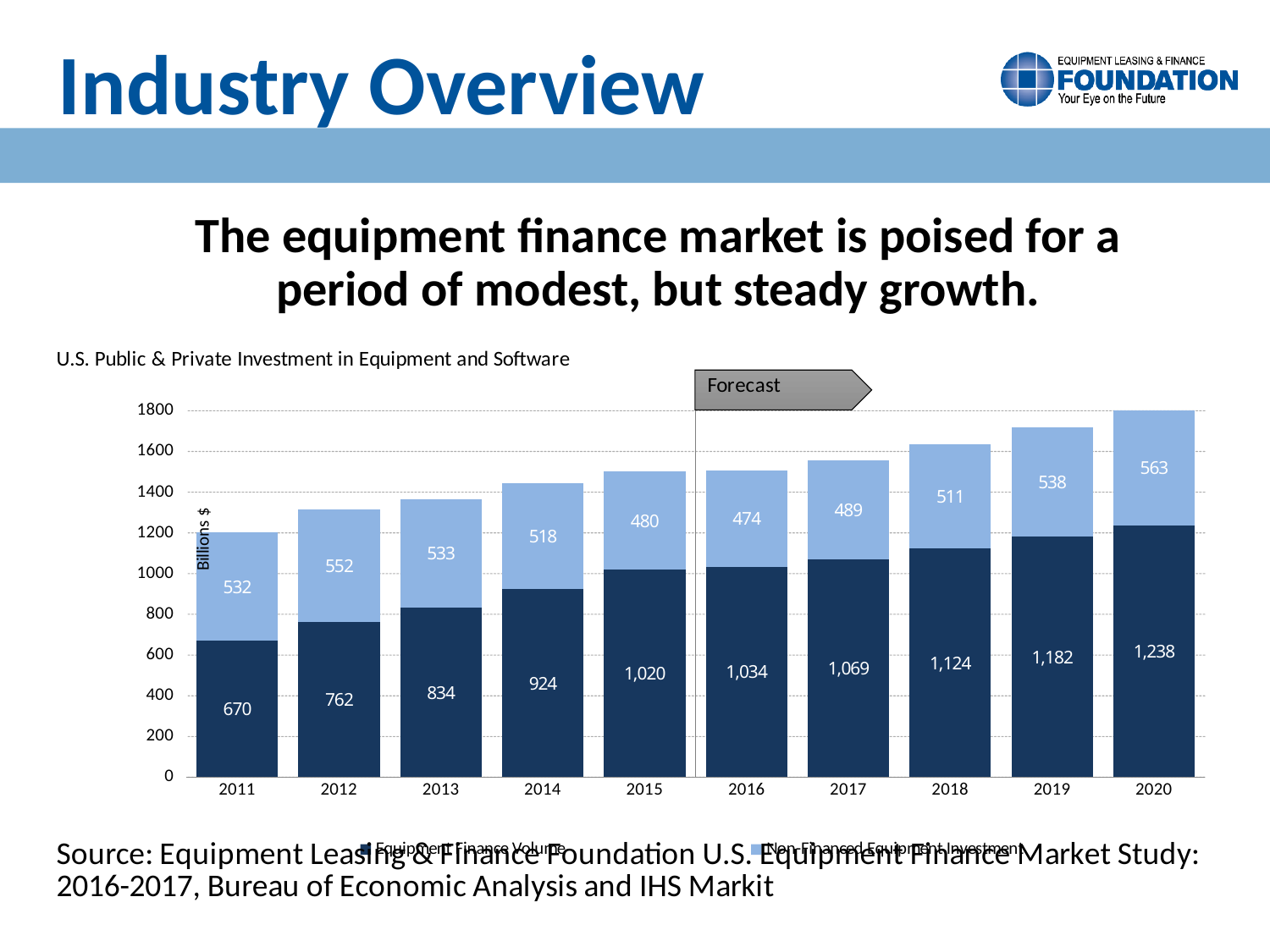
Is the total height of the 2020 stacked bar greater or less than 1600? greater What is the difference between the dark blue (bottom) segment values for 2020 and 2011? 568 Which year has the larger light blue (top) segment, 2012 or 2013? 2012 What is the value of the dark blue (bottom) segment for 2011? 670 How many years are shown on the x axis? 10 In which year is the light blue (top) segment the lowest? 2016 How many series are stacked in each bar? 2 In which year is the dark blue (bottom) segment the highest? 2020 Does the dark blue (bottom) segment rise or fall from 2011 to 2020? Rise What is the value of the light blue (top) segment for 2020? 563 What is the total of the stacked bar for 2011? 1,202 What kind of chart is shown on the slide? Stacked bar chart